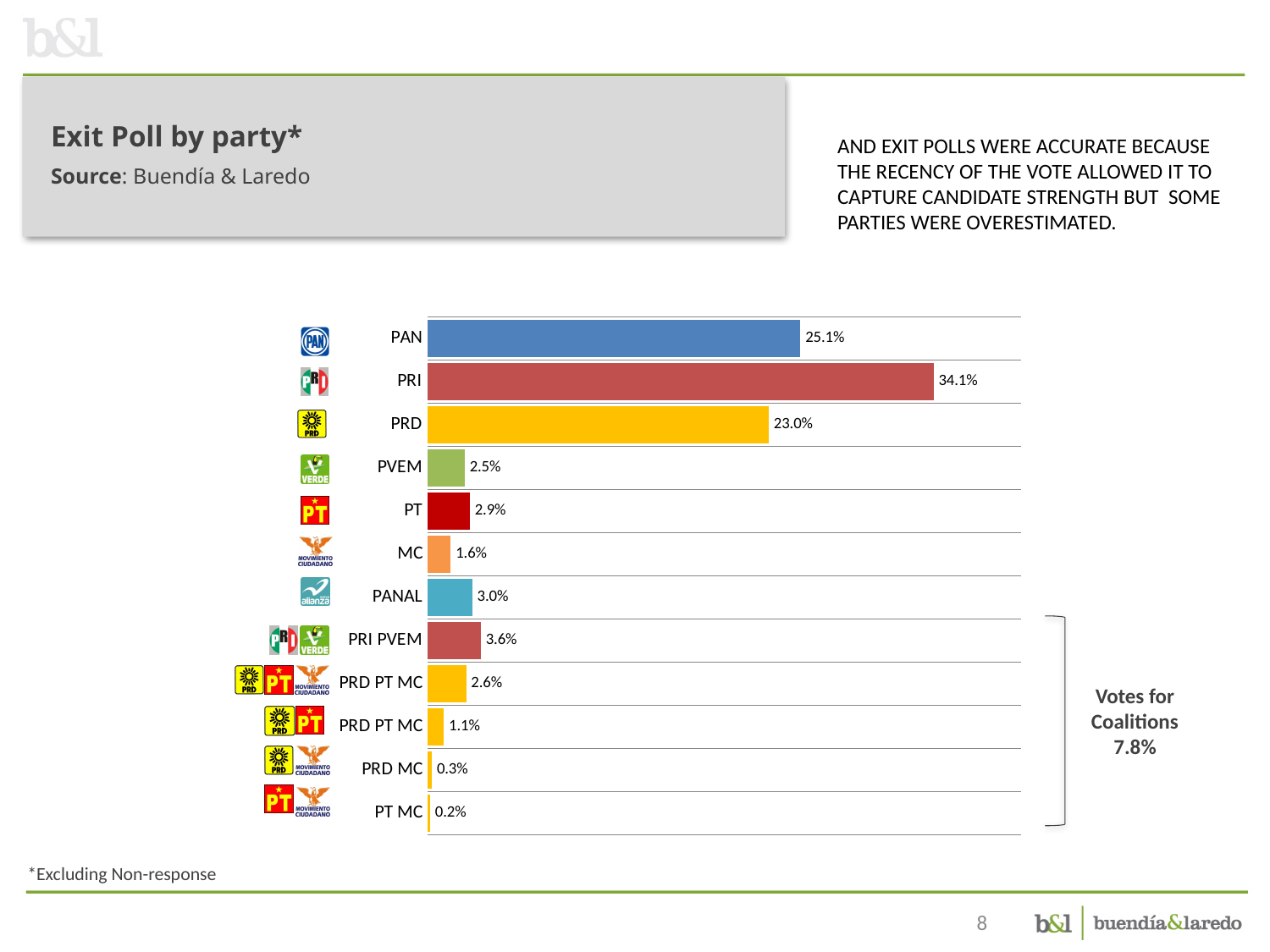
Which category has the lowest exit poll value? PT MC What is the exit poll value for PRI? 34.1% What is the title of the chart? Exit Poll by party* How many bars are shown in the chart? 12 What is the exit poll value for PANAL? 3.0% What kind of chart is shown on the slide? Bar chart What is the exit poll value for PAN? 25.1% Which party has the highest exit poll value? PRI Which has a higher exit poll value, PT or PVEM? PT What is the difference between the exit poll values for PAN and PRD? 2.1 percentage points What is the difference between the exit poll values for PRI and PAN? 9.0 percentage points What is the exit poll value for the PRI PVEM coalition? 3.6%